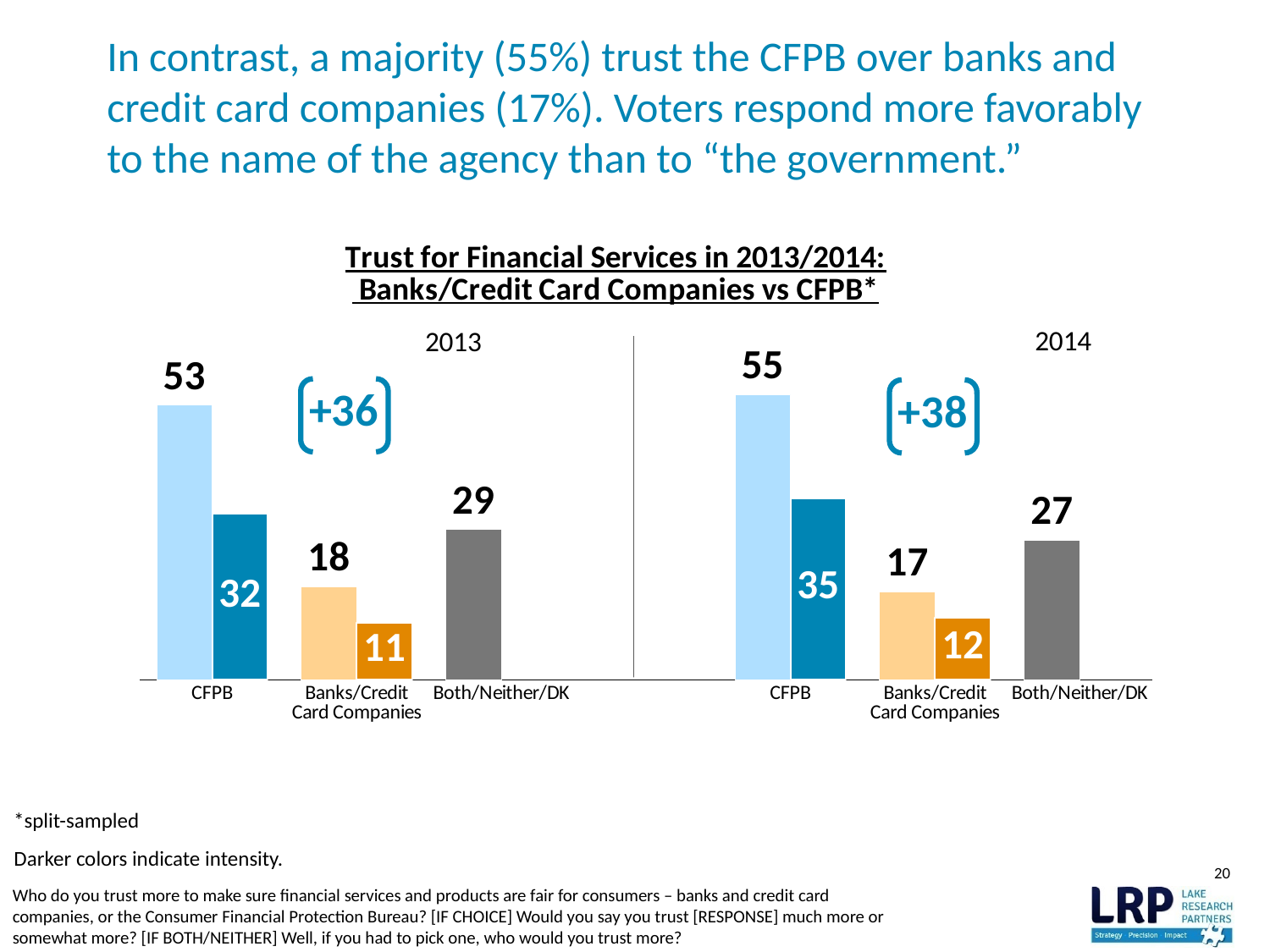
How many categories are shown on the x axis of the 2014 chart? 3 What type of chart is used on this slide? Bar chart In the 2014 chart, what is the value shown on the darker (intensity) bar for Banks/Credit Card Companies? 12 In the 2013 chart, what is the value for CFPB? 53 Which is larger: the CFPB value in the 2013 chart or the CFPB value in the 2014 chart? 2014 In the 2014 chart, which category has the lowest value? Banks/Credit Card Companies In the 2014 chart, what is the value for Both/Neither/DK? 27 In the 2013 chart, which category has the highest value? CFPB In the 2014 chart, what is the value for Banks/Credit Card Companies? 17 In the 2013 chart, what is the value shown on the darker (intensity) bar for CFPB? 32 In the 2013 chart, what is the difference between the CFPB value and the Banks/Credit Card Companies value? 35 In the 2014 chart, what is the difference between the CFPB value and the Banks/Credit Card Companies value? 38